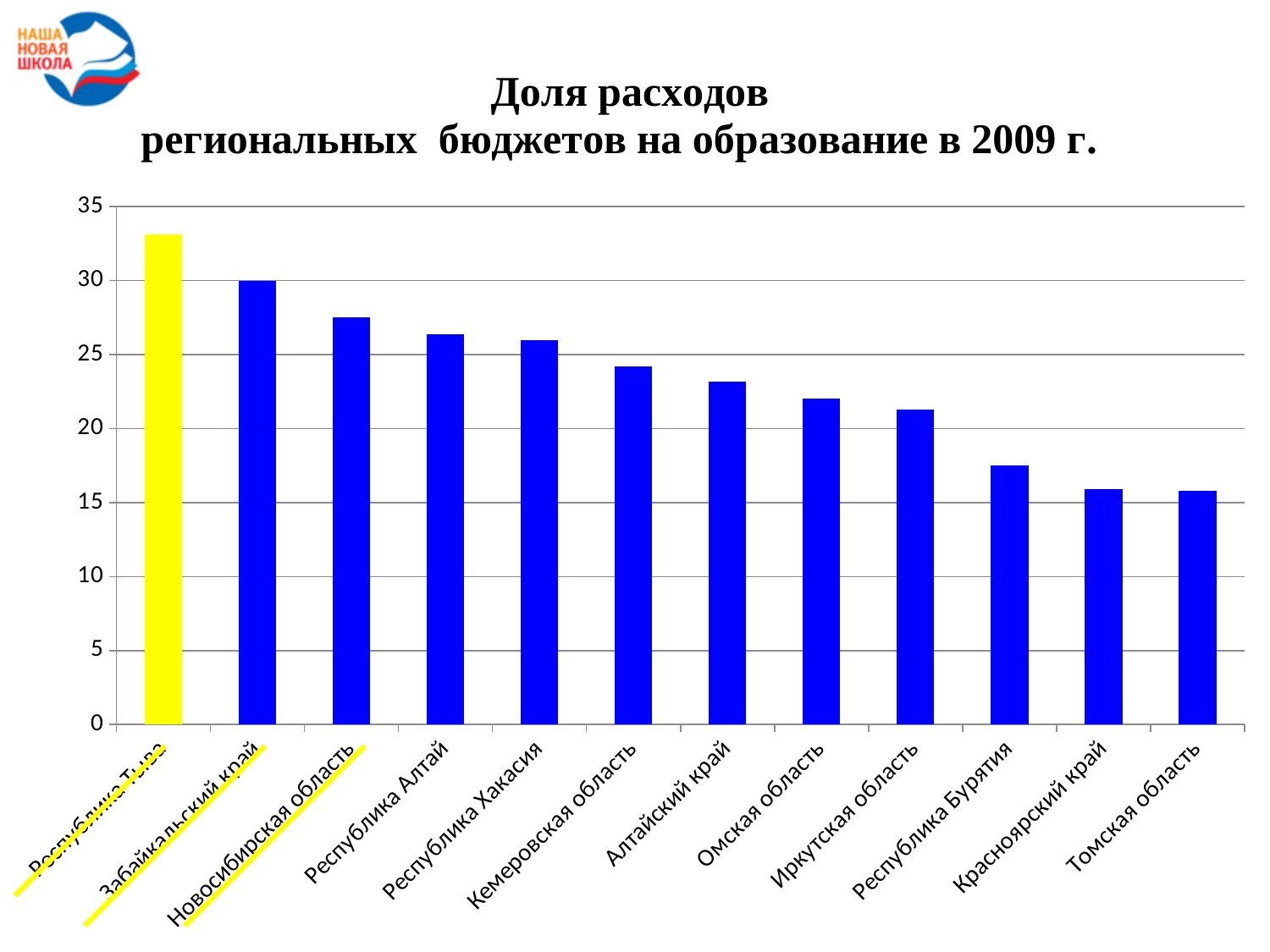
Which is larger, the value for Республика Хакасия or the value for Красноярский край? Республика Хакасия Is the value for Новосибирская область greater or less than 25? greater What kind of chart is shown on the slide? bar chart Which region has the highest share of regional budget spending on education? Республика Тыва How many regions are shown on the chart? 12 Is the value for Томская область greater or less than 15? greater Is the value for Республика Бурятия greater or less than 20? less Which is larger, the value for Новосибирская область or the value for Омская область? Новосибирская область What colour is the bar for the first region on the chart? yellow Do the values rise or fall from left to right along the x axis? fall